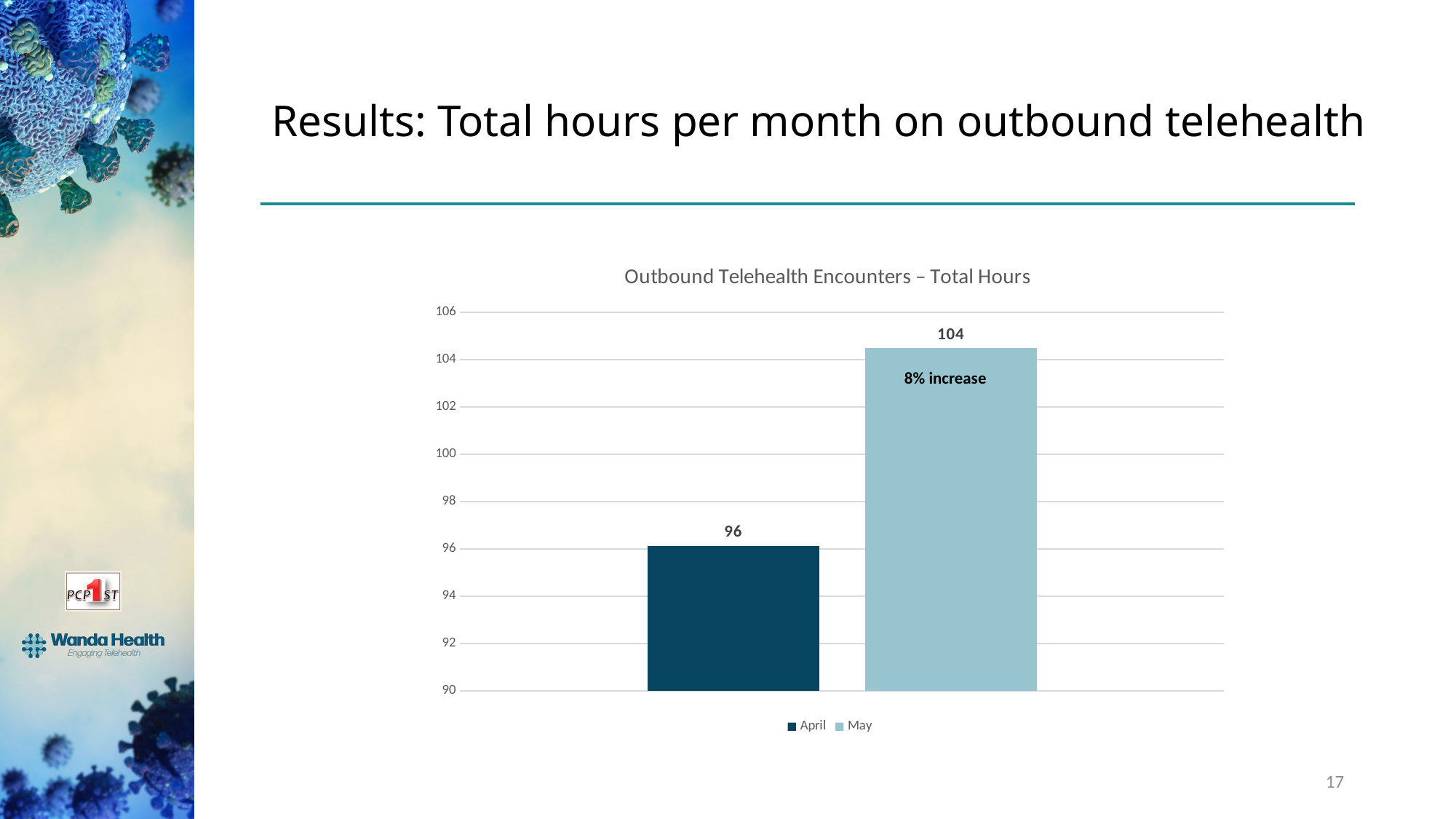
Which month has the higher total hours, April or May? May Which month has the lowest total hours in the chart? April How many series does the legend list? 2 What is the value for May in the Outbound Telehealth Encounters – Total Hours chart? 104 Is the value for April greater or less than 100? less Is the value for May greater or less than 100? greater What percentage increase is annotated on the May bar? 8% increase Which month has the highest total hours in the chart? May What is the difference in total hours between May and April? 8 What kind of chart is shown on the slide? Bar chart What is the title of the chart? Outbound Telehealth Encounters – Total Hours What is the value for April in the Outbound Telehealth Encounters – Total Hours chart? 96